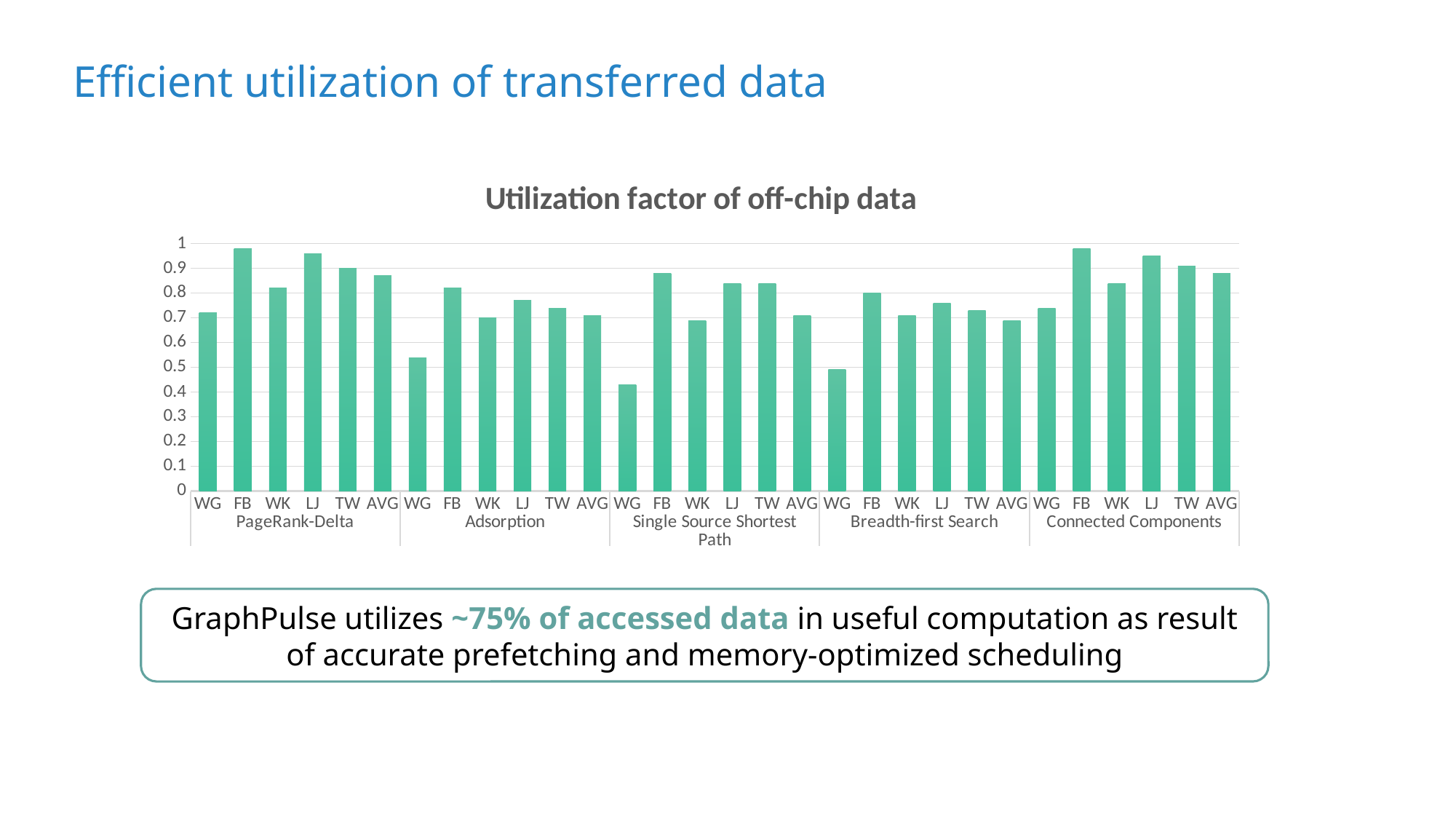
How many algorithm groups are shown along the x axis of the chart? 5 Is the utilization factor for WG in the Single Source Shortest Path group greater or less than 0.5? less Is the utilization factor for FB in the PageRank-Delta group greater or less than 0.9? greater Which input has the highest utilization factor in the Adsorption group? FB How many bars are plotted in the chart in total? 30 What is the title of the chart? Utilization factor of off-chip data Is the utilization factor for WG in the Adsorption group greater or less than 0.6? less Which input has the lowest utilization factor in the Single Source Shortest Path group? WG What kind of chart is shown on the slide? bar chart Which input has the lowest utilization factor in the Breadth-first Search group? WG Which is larger: the utilization factor for LJ in Connected Components or for LJ in Adsorption? LJ in Connected Components Which is larger: the utilization factor for WG in PageRank-Delta or for WG in Breadth-first Search? WG in PageRank-Delta